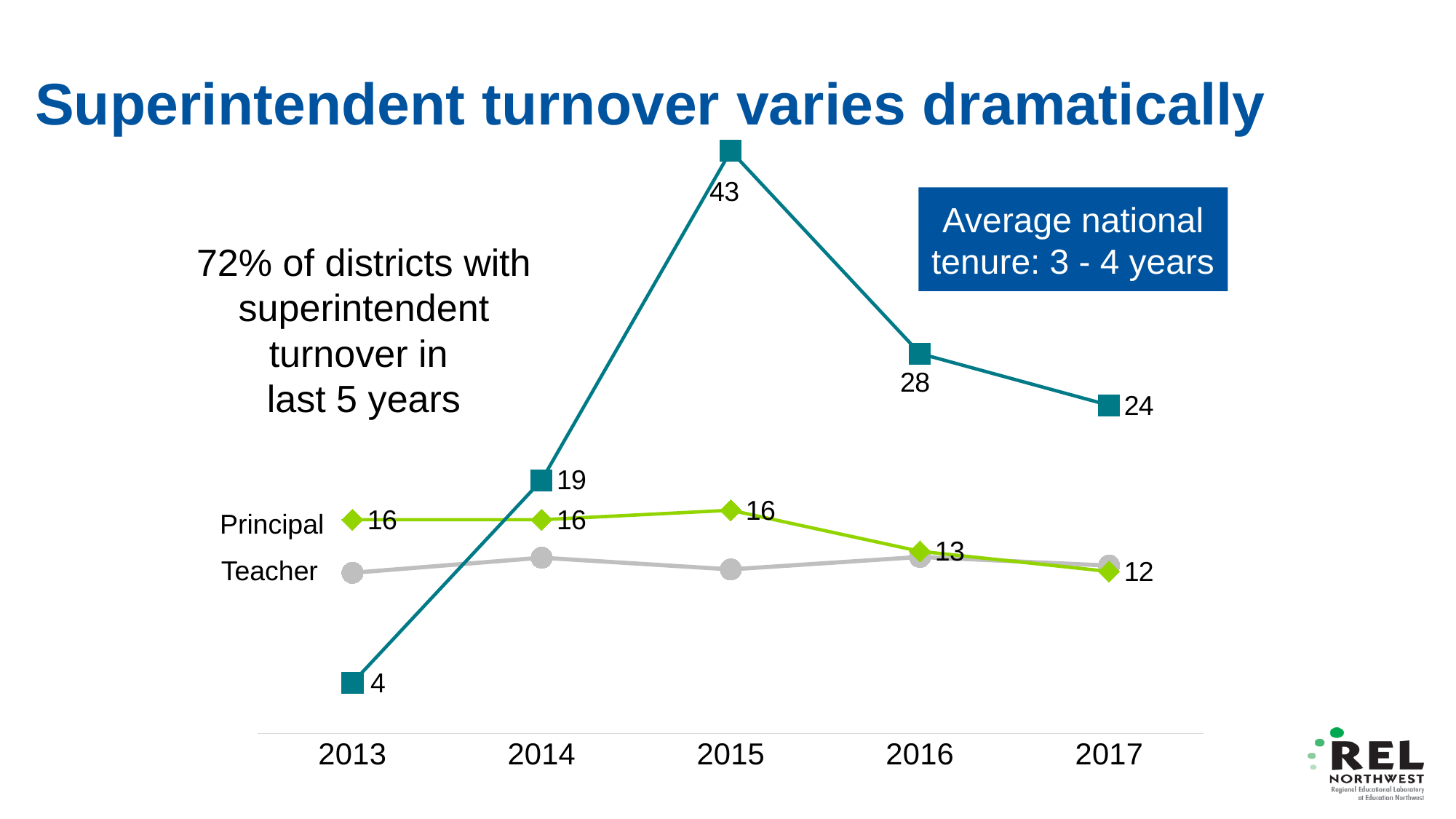
In which year is the superintendent turnover (teal line) highest? 2015 What is the superintendent turnover value (teal line with square markers) for 2015? 43 Does the Principal line rise or fall from 2015 to 2017? Fall What is the Principal value for 2016? 13 By how much did the superintendent turnover (teal line) drop from 2015 to 2016? 15 How many lines (series) are plotted on the chart? 3 In which year is the superintendent turnover (teal line) lowest? 2013 What kind of chart is shown on the slide? Line chart How many years are shown on the x axis? 5 In 2014, which is larger: the superintendent turnover (teal line) or the Principal value? Superintendent What is the superintendent turnover value (teal line) for 2013? 4 What is the difference between the Principal value in 2013 and in 2017? 4